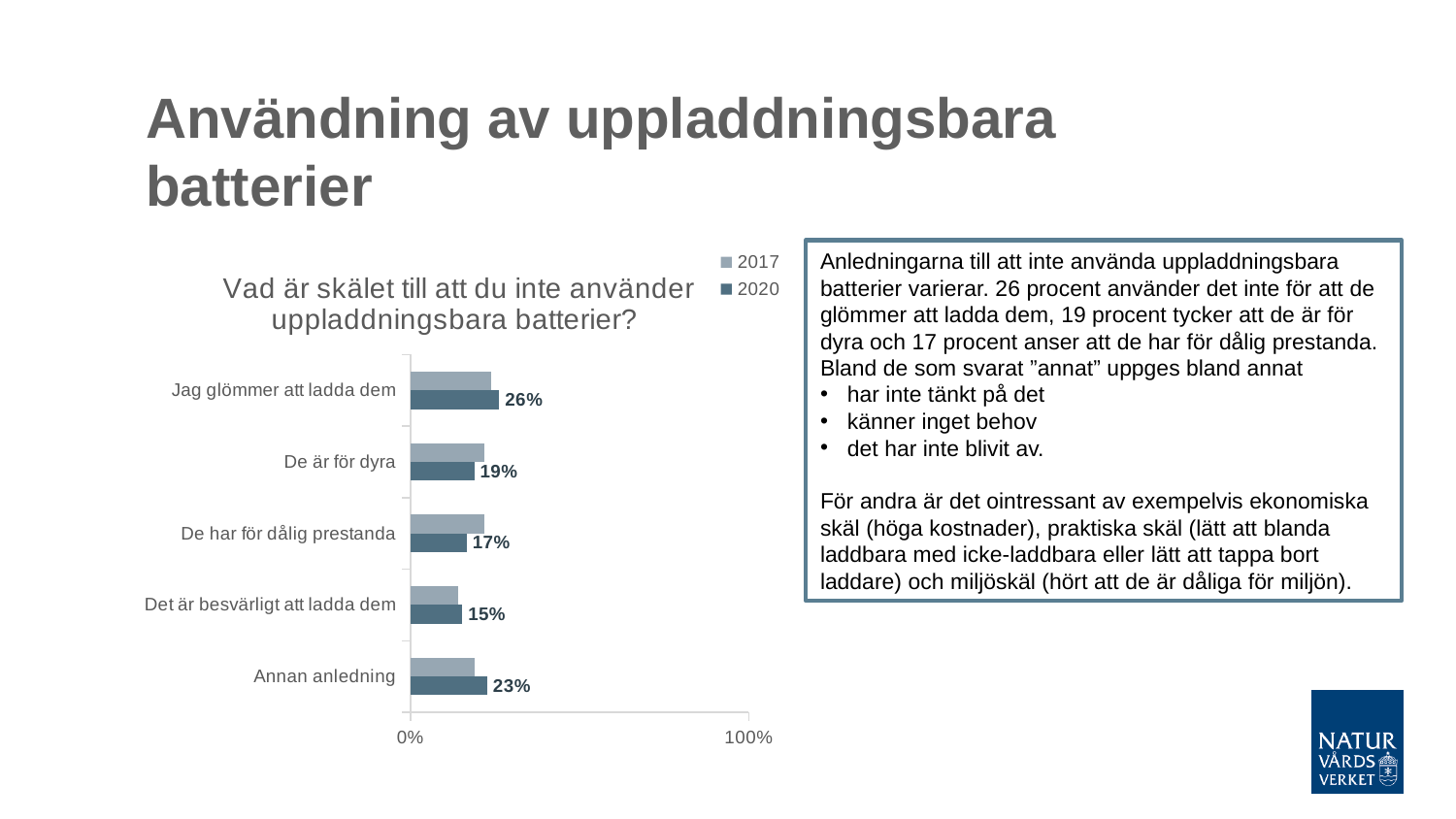
What is the 2020 value for "Jag glömmer att ladda dem"? 26% What is the 2020 value for "De har för dålig prestanda"? 17% What is the 2020 value for "Det är besvärligt att ladda dem"? 15% Which category has the highest 2020 value? Jag glömmer att ladda dem What is the 2020 value for "Annan anledning"? 23% How many series does the legend list? 2 What is the 2020 value for "De är för dyra"? 19% Which has a larger 2020 value, "Annan anledning" or "De har för dålig prestanda"? Annan anledning What is the difference between the 2020 values for "Jag glömmer att ladda dem" and "De är för dyra"? 7% How many categories are shown in the chart? 5 Which category has the lowest 2020 value? Det är besvärligt att ladda dem What type of chart is shown on the slide? Bar chart